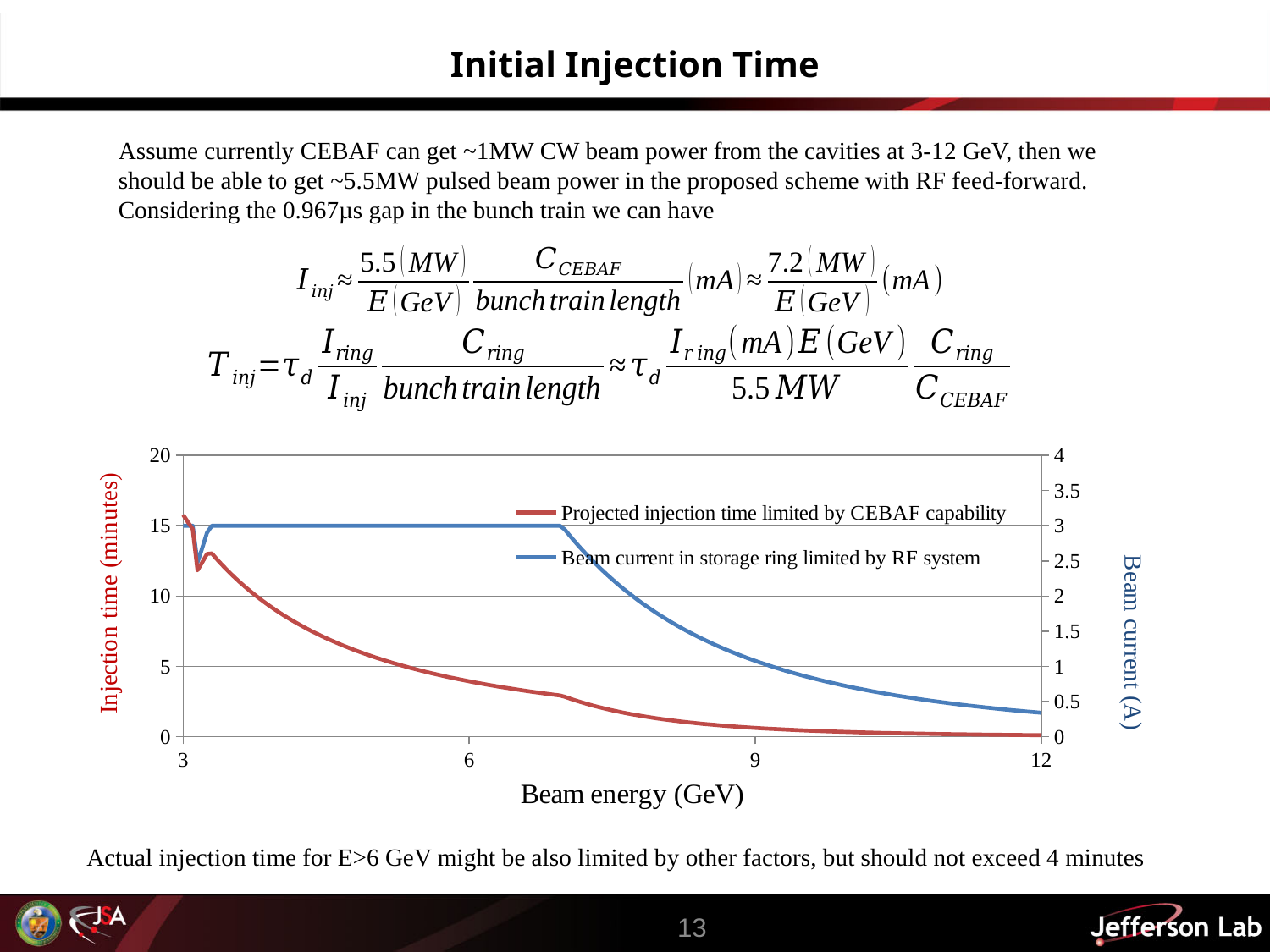
Does the projected injection time limited by CEBAF capability rise or fall as beam energy increases from 3 to 12 GeV? fall Is the projected injection time at 9 GeV greater or less than 5 minutes? less Does the beam current in the storage ring limited by RF system rise or fall as beam energy increases from 7 to 12 GeV? fall Is the beam current in the storage ring at 6 GeV greater or less than 2 A? greater What is the title of the horizontal axis of the chart? Beam energy (GeV) Is the projected injection time at 3 GeV greater or less than 10 minutes? greater What kind of chart is shown on the slide? line chart Is the projected injection time higher at 6 GeV or at 12 GeV? 6 GeV At which beam energy shown on the x axis is the projected injection time highest? 3 GeV What is the title of the right-hand vertical axis of the chart? Beam current (A) How many series does the chart's legend list? 2